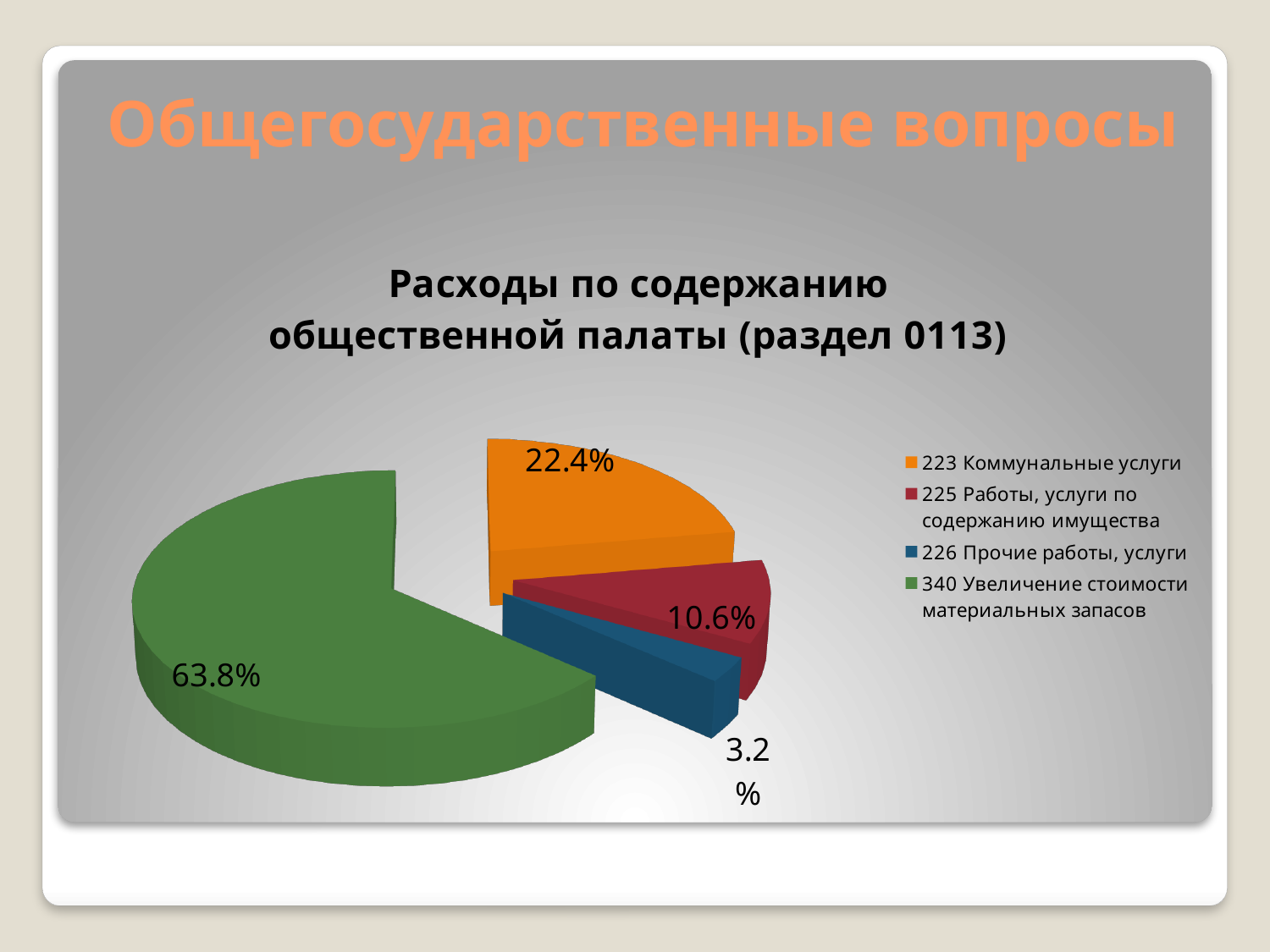
What share does the slice for 223 Коммунальные услуги have? 22.4% What share does the slice for 340 Увеличение стоимости материальных запасов have? 63.8% What is the difference between the shares for 223 Коммунальные услуги and 225 Работы, услуги по содержанию имущества? 11.8% How many slices does the pie chart have? 4 What is the chart's title? Расходы по содержанию общественной палаты (раздел 0113) What kind of chart is shown on the slide? Pie chart What colour is the slice for 340 Увеличение стоимости материальных запасов? Green Which category has the largest slice of the pie? 340 Увеличение стоимости материальных запасов Which category has the smallest slice of the pie? 226 Прочие работы, услуги What share does the slice for 226 Прочие работы, услуги have? 3.2% What share does the slice for 225 Работы, услуги по содержанию имущества have? 10.6% Which is larger: the share for 225 Работы, услуги по содержанию имущества or the share for 226 Прочие работы, услуги? 225 Работы, услуги по содержанию имущества